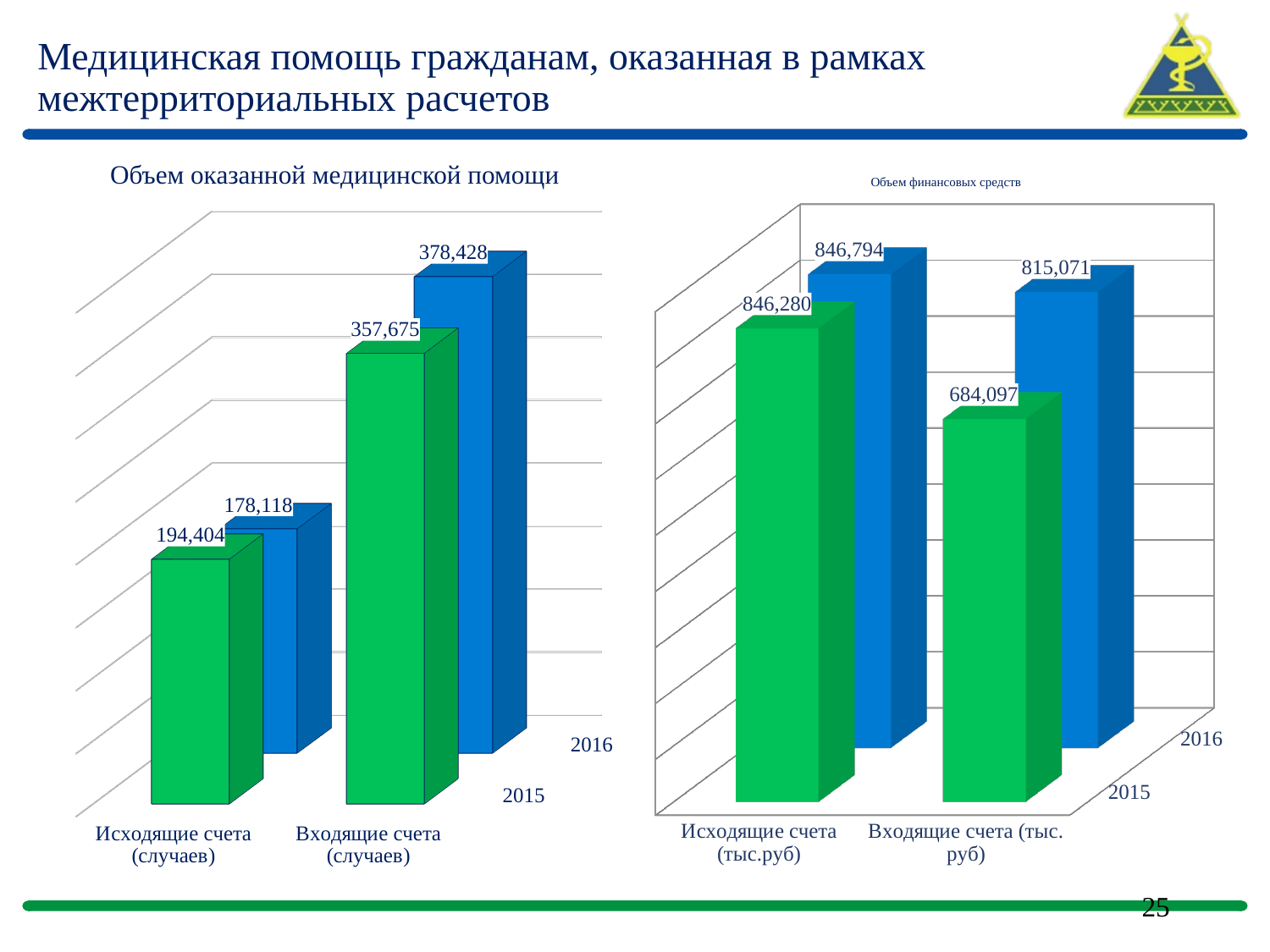
In the chart 'Объем финансовых средств', what is the value for Исходящие счета (тыс.руб) in 2016? 846,794 In the chart 'Объем оказанной медицинской помощи', which bar has the highest value? Входящие счета (случаев), 2016 In the chart 'Объем оказанной медицинской помощи', what is the value for Исходящие счета (случаев) in 2015? 194,404 In the chart 'Объем финансовых средств', what is the value for Входящие счета (тыс. руб) in 2015? 684,097 In the chart 'Объем оказанной медицинской помощи', what is the difference between the 2016 and 2015 values for Входящие счета (случаев)? 20,753 In the chart 'Объем оказанной медицинской помощи', what is the value for Входящие счета (случаев) in 2016? 378,428 How many series (years) are plotted in the chart 'Объем оказанной медицинской помощи'? 2 What type of chart is 'Объем финансовых средств'? Bar chart In the chart 'Объем оказанной медицинской помощи', which is larger for Исходящие счета (случаев): the 2015 value or the 2016 value? 2015 In the chart 'Объем финансовых средств', what is the difference between the 2016 and 2015 values for Входящие счета (тыс. руб)? 130,974 How many categories are shown on the x axis of the chart 'Объем финансовых средств'? 2 In the chart 'Объем финансовых средств', which bar has the lowest value? Входящие счета (тыс. руб), 2015